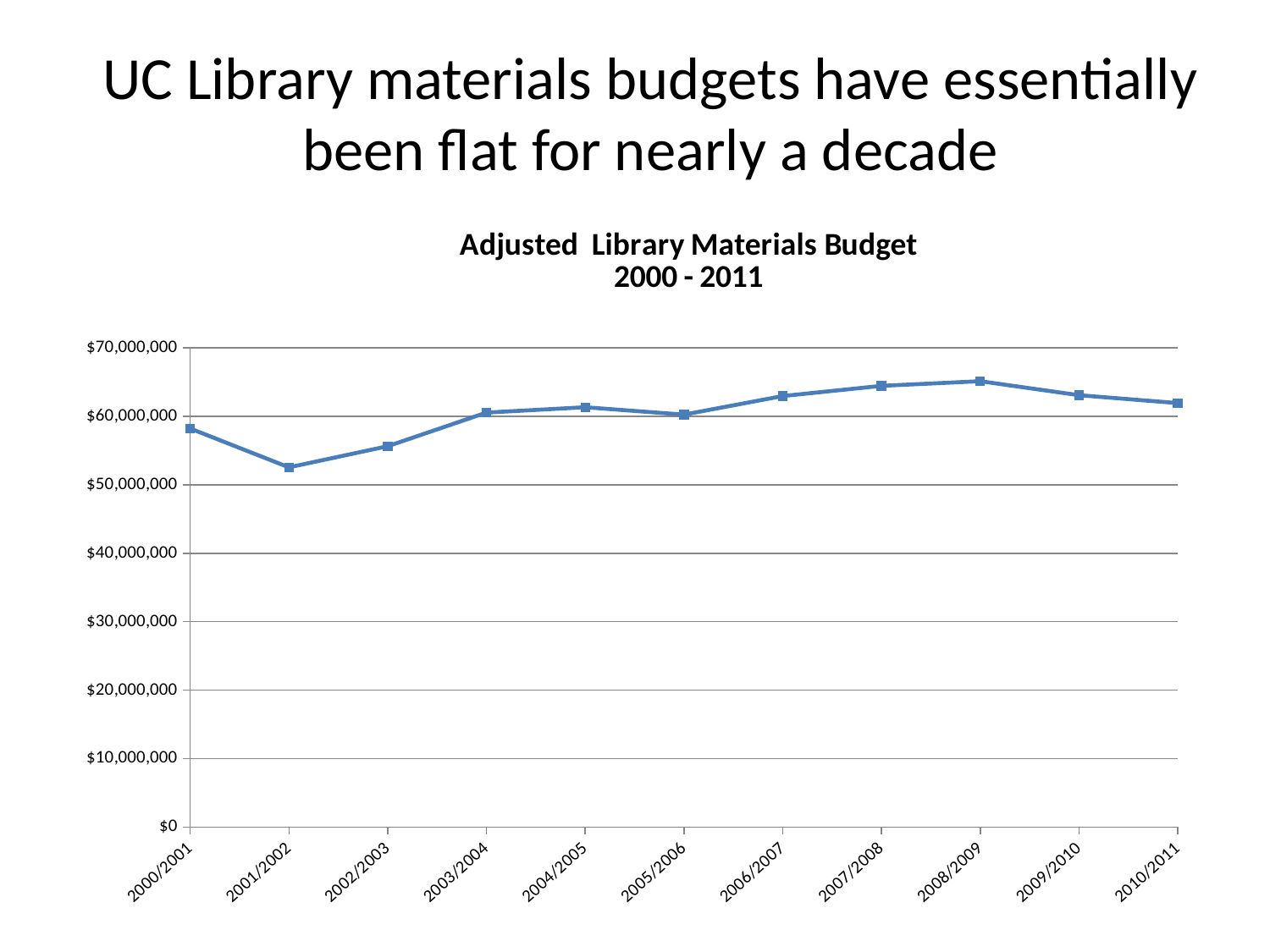
How many fiscal years are plotted on the x axis? 11 Is the value for 2008/2009 greater or less than $60,000,000? greater Is the value for 2001/2002 greater or less than $50,000,000? greater Which is larger, the budget for 2000/2001 or for 2001/2002? 2000/2001 What kind of chart is shown on the slide? Line chart Which fiscal year has the lowest adjusted library materials budget? 2001/2002 Is the value for 2002/2003 greater or less than $60,000,000? less Does the budget rise or fall from 2008/2009 to 2010/2011? Fall What is the title of the chart? Adjusted Library Materials Budget 2000 - 2011 Which is larger, the budget for 2006/2007 or for 2002/2003? 2006/2007 Which fiscal year has the highest adjusted library materials budget? 2008/2009